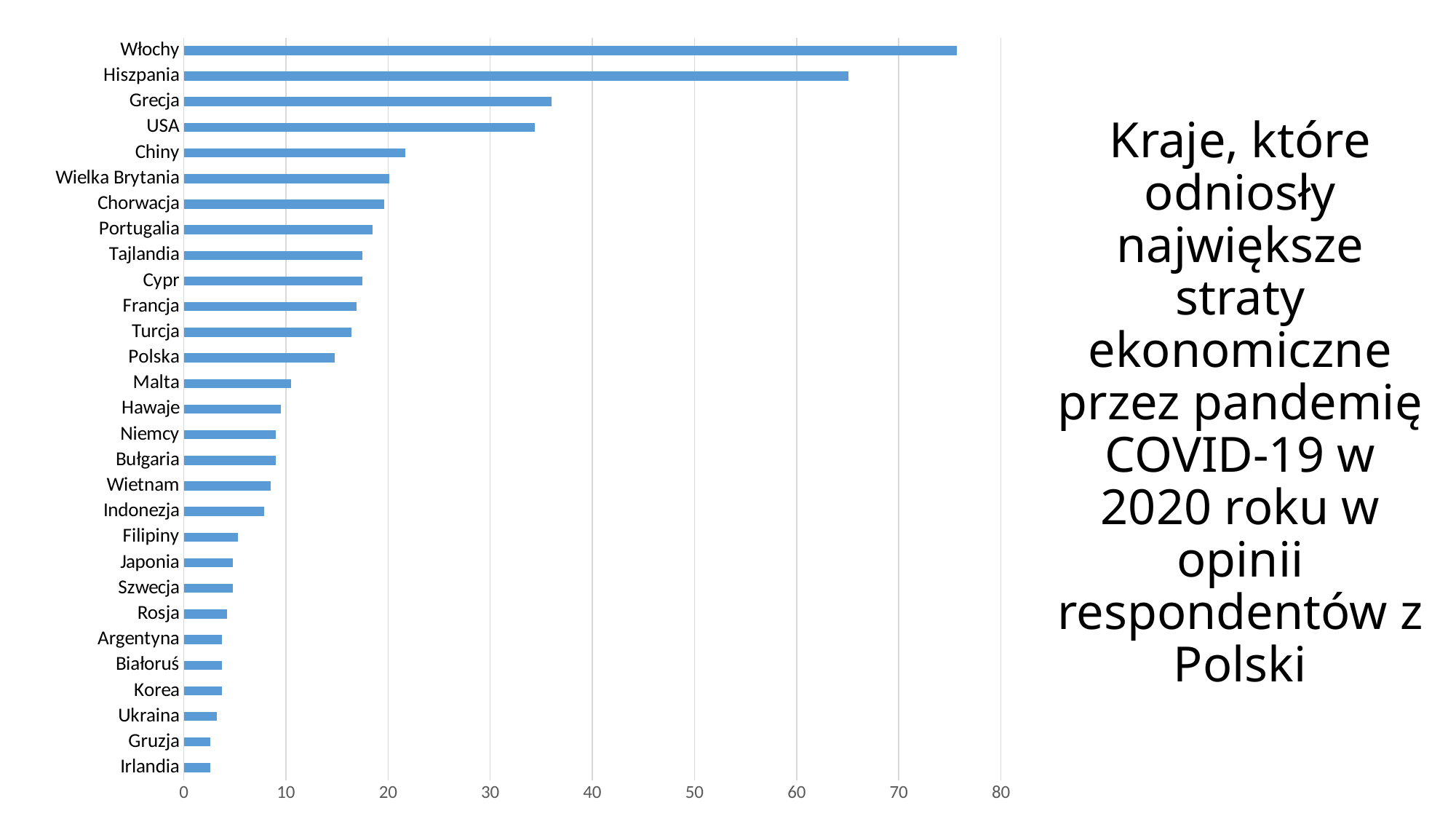
Do the bar values increase or decrease going from the top of the chart to the bottom? decrease What kind of chart is shown on the slide? bar chart Which country has the highest value on the chart? Włochy Which has a larger value, Turcja or Polska? Turcja Is the value for Hiszpania greater or less than 60? greater Which has a larger value, Włochy or Hiszpania? Włochy Is the value for Włochy greater or less than 70? greater Is the value for Niemcy greater or less than 10? less How many countries are listed on the chart? 29 Which has a larger value, Grecja or Chiny? Grecja